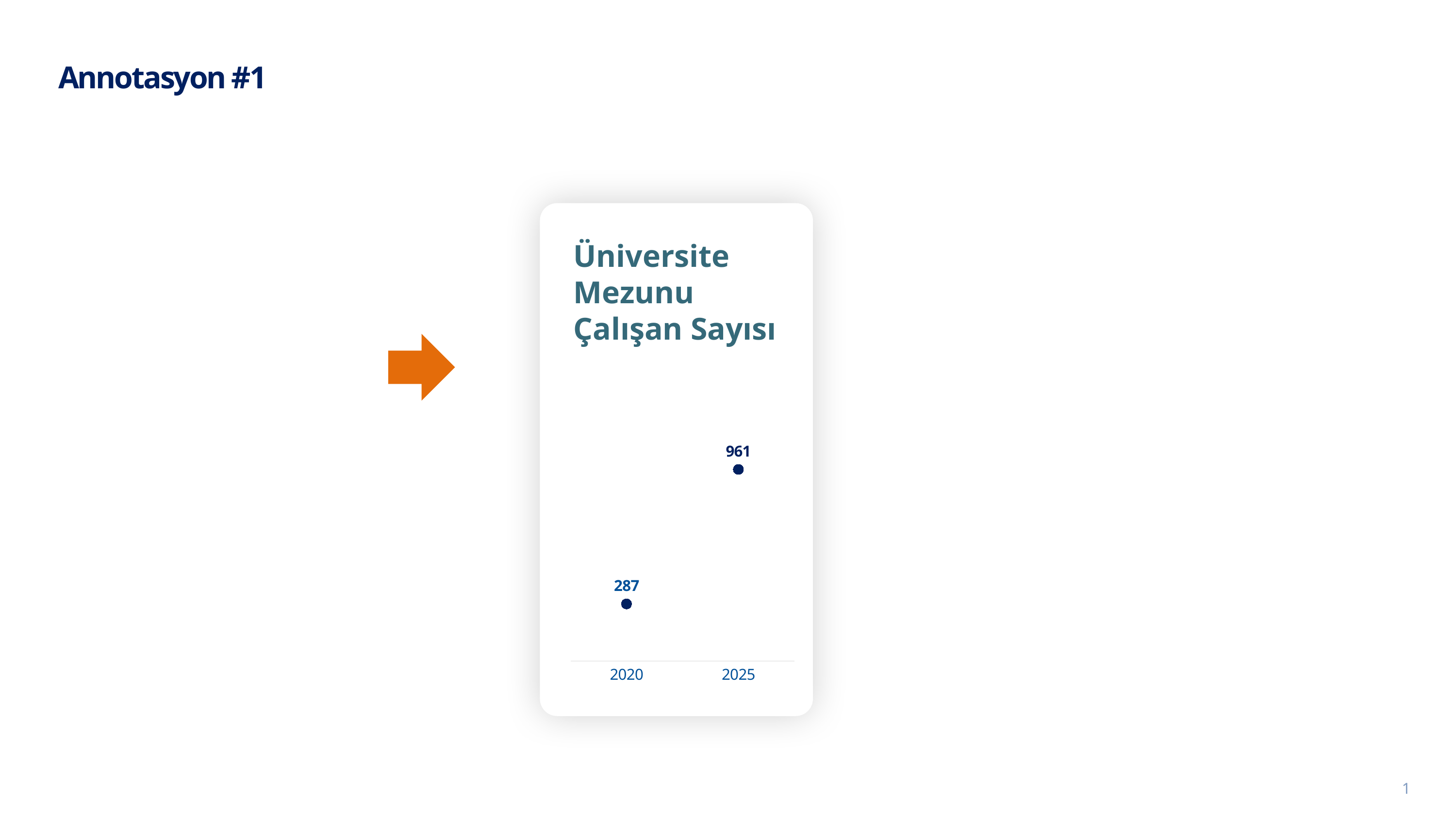
Which is larger, the value for 2020 or the value for 2025? 2025 What is the difference between the 2025 and 2020 values? 674 Do the values rise or fall from 2020 to 2025? rise What years are shown on the x axis of the chart? 2020 and 2025 What is the value for 2020 in the Üniversite Mezunu Çalışan Sayısı chart? 287 How many data points are plotted in the chart? 2 Which year has the lowest value in the chart? 2020 What is the title of the chart? Üniversite Mezunu Çalışan Sayısı Which year has the highest value in the chart? 2025 What is the value for 2025 in the Üniversite Mezunu Çalışan Sayısı chart? 961